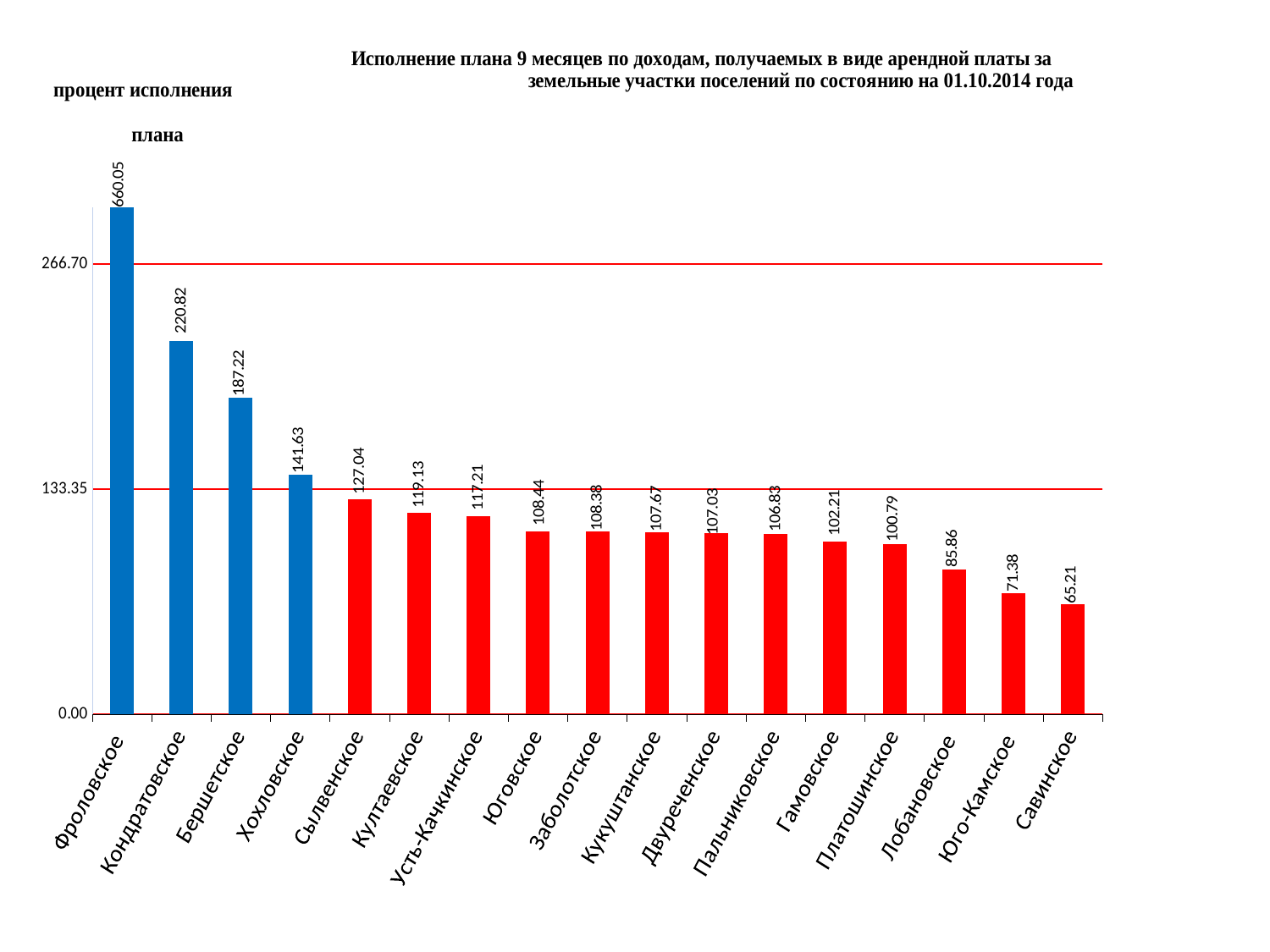
What is the value for Лобановское? 85.86 Do the values rise or fall from left to right along the x axis? fall What is the value for Фроловское? 660.05 Which category has the lowest value? Савинское What is the difference between the values for Кондратовское and Бершетское? 33.60 How many categories are shown on the x axis? 17 What kind of chart is shown on the slide? bar chart Which is larger, the value for Сылвенское or the value for Юго-Камское? Сылвенское What is the value for Хохловское? 141.63 Which category has the highest value? Фроловское What is the difference between the values for Фроловское and Савинское? 594.84 Is the value for Бершетское greater or less than 133.35? greater